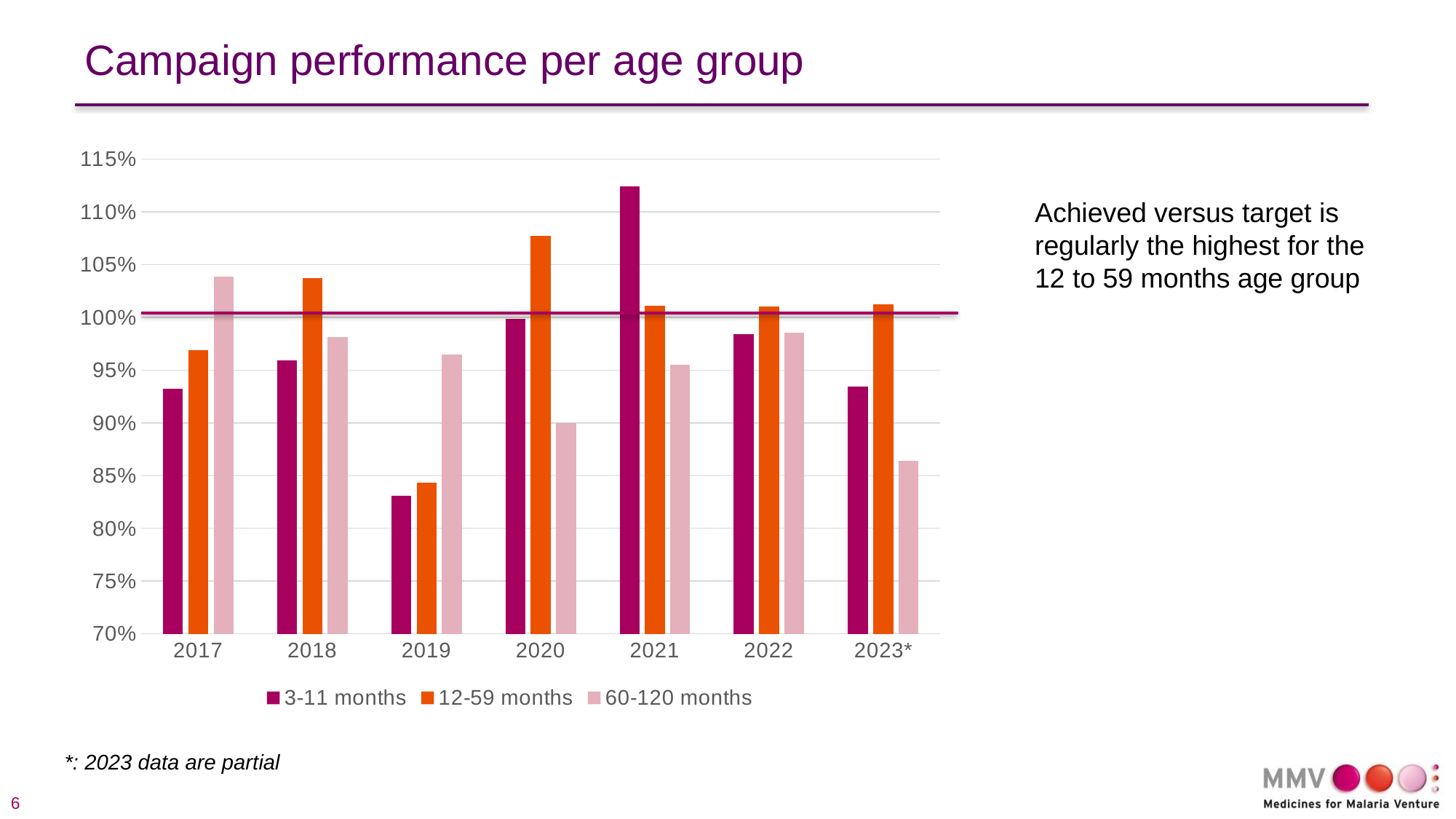
Which age group has the highest value in 2019? 60-120 months What colour represents the 12-59 months series in the legend? Orange Is the value for 60-120 months in 2017 greater or less than 100%? greater Is the value for 12-59 months in 2020 greater or less than 105%? greater Which year and age group has the lowest bar in the chart? 3-11 months in 2019 What kind of chart is shown on the slide? Bar chart How many series does the legend list? 3 Is the value for 3-11 months in 2019 greater or less than 85%? less In 2023*, which is larger: the value for 12-59 months or the value for 60-120 months? 12-59 months Does the value for 3-11 months rise or fall from 2019 to 2021? Rise Which year and age group has the highest bar in the chart? 3-11 months in 2021 How many years are shown on the x axis? 7